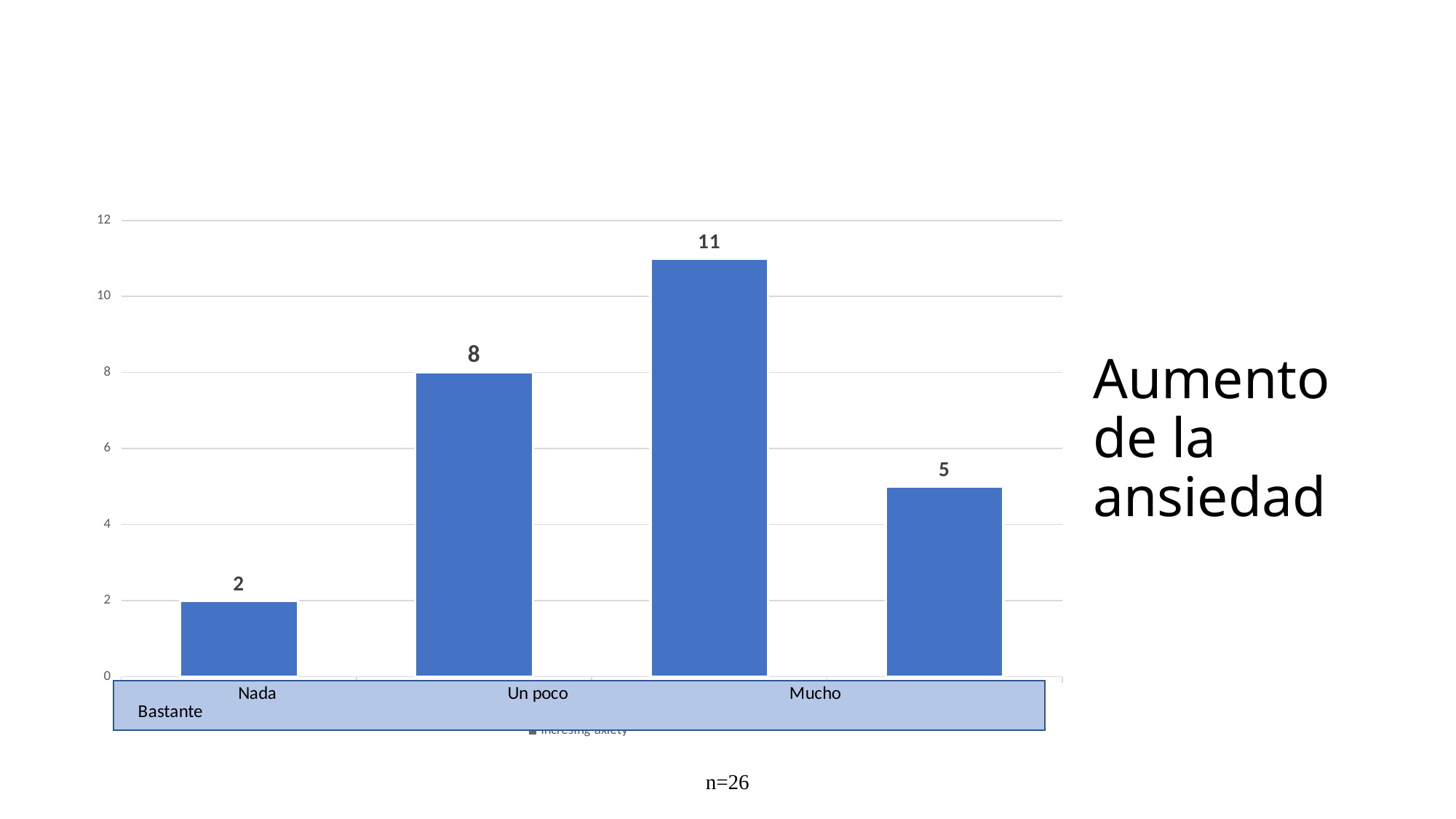
How many bars are plotted in the chart? 4 What is the difference between the tallest bar and the shortest bar? 9 What is the highest value shown in the chart? 11 What is the difference between the second bar (8) and the rightmost bar (5)? 3 What is the value of the leftmost bar in the chart? 2 What is the lowest value shown in the chart? 2 What is the value of the rightmost bar in the chart? 5 What is the total of all four bar values in the chart? 26 Which is larger: the second bar from the left or the rightmost bar? the second bar from the left What is the value of the second bar from the left? 8 What kind of chart is shown on the slide? bar chart What is the title text shown to the right of the chart? Aumento de la ansiedad